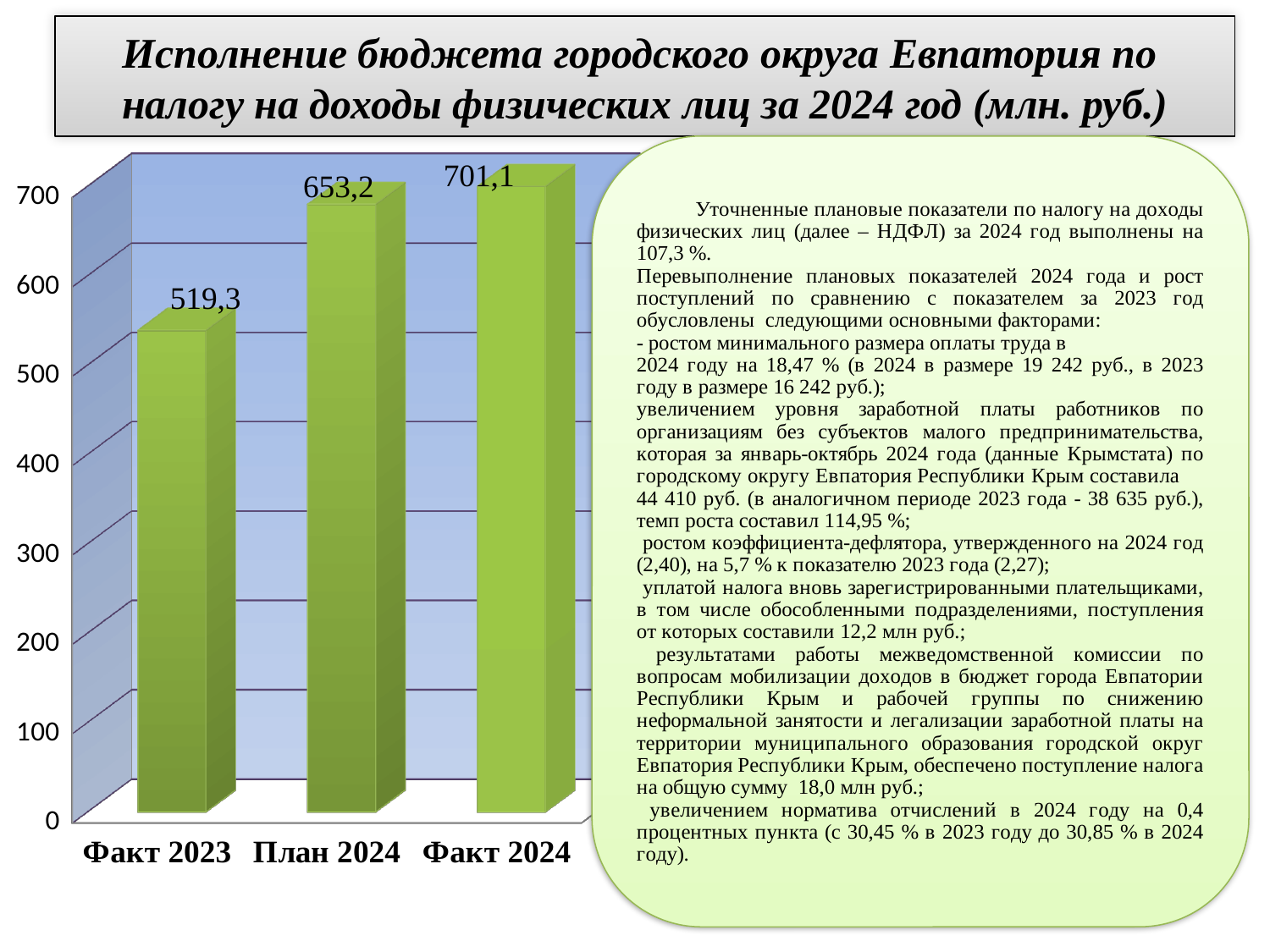
Which is larger, Факт 2023 or План 2024? План 2024 What is the difference between Факт 2024 and Факт 2023? 181,8 Which category has the lowest value? Факт 2023 How many categories are shown on the chart? 3 What is the difference between План 2024 and Факт 2023? 133,9 What is the value for План 2024? 653,2 Is the value for Факт 2023 greater or less than 500? greater What kind of chart is shown on the slide? bar chart Which category has the highest value? Факт 2024 What is the difference between Факт 2024 and План 2024? 47,9 What is the value for Факт 2024? 701,1 What is the value for Факт 2023? 519,3